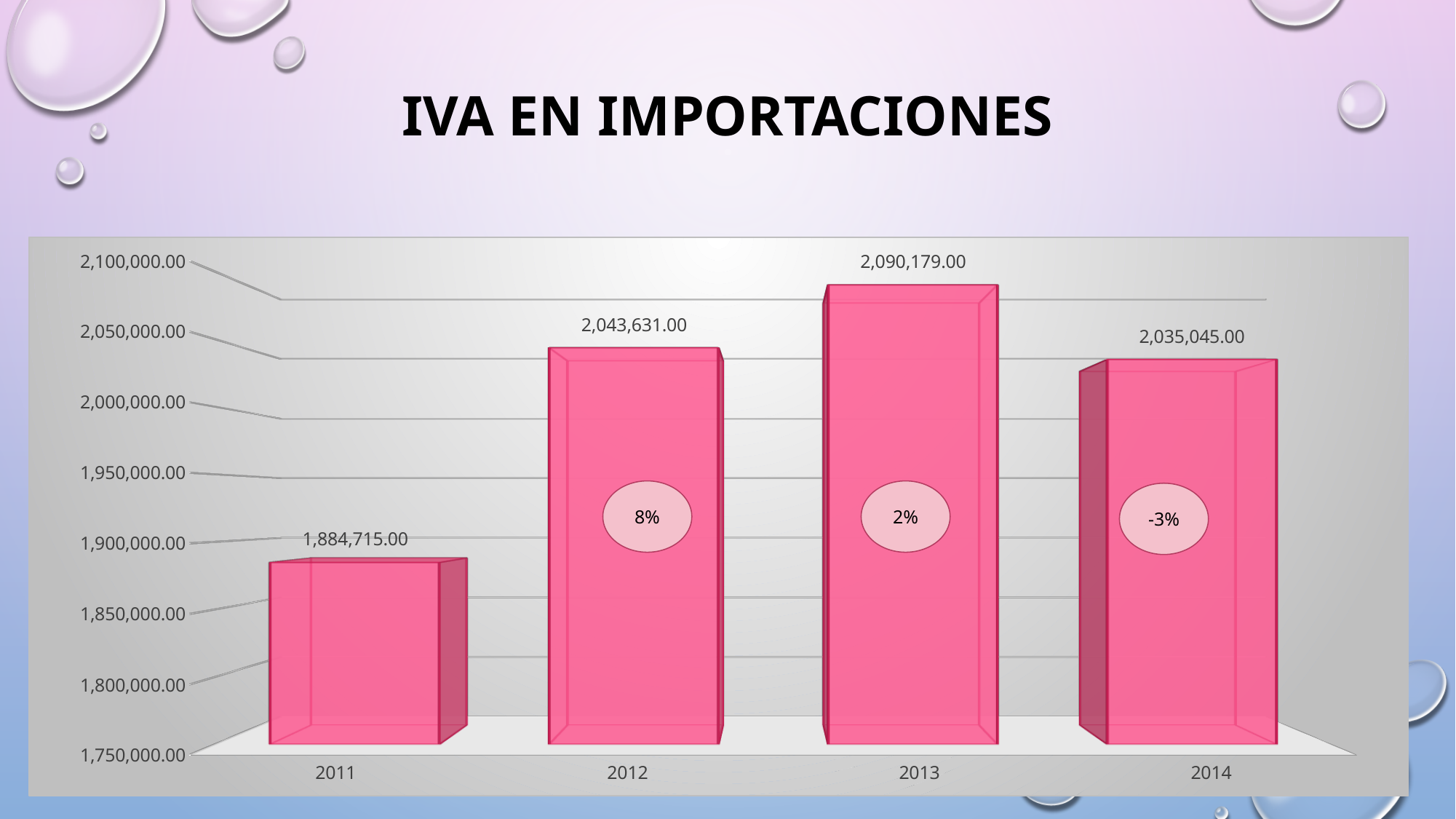
What is the difference between the values for 2012 and 2011? 158,916.00 What percentage change is shown in the circle on the 2014 bar? -3% Is the value for 2011 greater or less than 1,900,000.00? less What kind of chart is shown on the slide? bar chart How many years are shown on the x axis? 4 What is the value for 2014? 2,035,045.00 Which year has the lowest value? 2011 Which year has the highest value? 2013 What is the difference between the values for 2013 and 2012? 46,548.00 Which is larger, the value for 2012 or the value for 2014? 2012 What is the value for 2011? 1,884,715.00 What is the value for 2013? 2,090,179.00